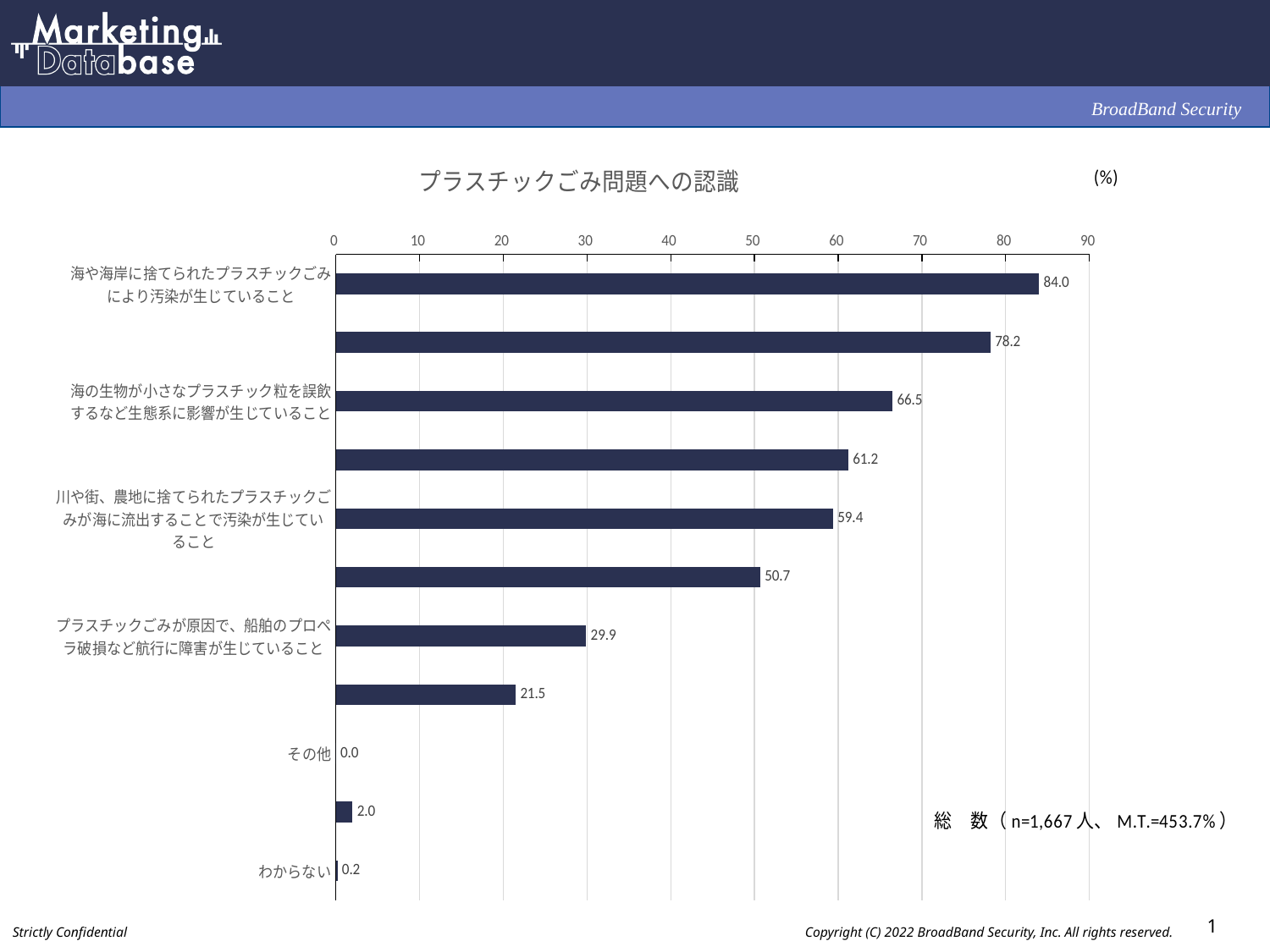
Which category has the highest value? 海や海岸に捨てられたプラスチックごみにより汚染が生じていること How many bars are plotted in the chart? 11 What is the value for わからない? 0.2 What is the difference between the values for 海や海岸に捨てられたプラスチックごみにより汚染が生じていること and 海の生物が小さなプラスチック粒を誤飲するなど生態系に影響が生じていること? 17.5 What kind of chart is shown on the slide? Bar chart What is the value for 海の生物が小さなプラスチック粒を誤飲するなど生態系に影響が生じていること? 66.5 What is the value for プラスチックごみが原因で、船舶のプロペラ破損など航行に障害が生じていること? 29.9 What is the value for 海や海岸に捨てられたプラスチックごみにより汚染が生じていること? 84.0 What is the title of the chart? プラスチックごみ問題への認識 Which category has the lowest value? その他 Which is larger, the value for 川や街、農地に捨てられたプラスチックごみが海に流出することで汚染が生じていること or the value for プラスチックごみが原因で、船舶のプロペラ破損など航行に障害が生じていること? 川や街、農地に捨てられたプラスチックごみが海に流出することで汚染が生じていること What is the value for 川や街、農地に捨てられたプラスチックごみが海に流出することで汚染が生じていること? 59.4